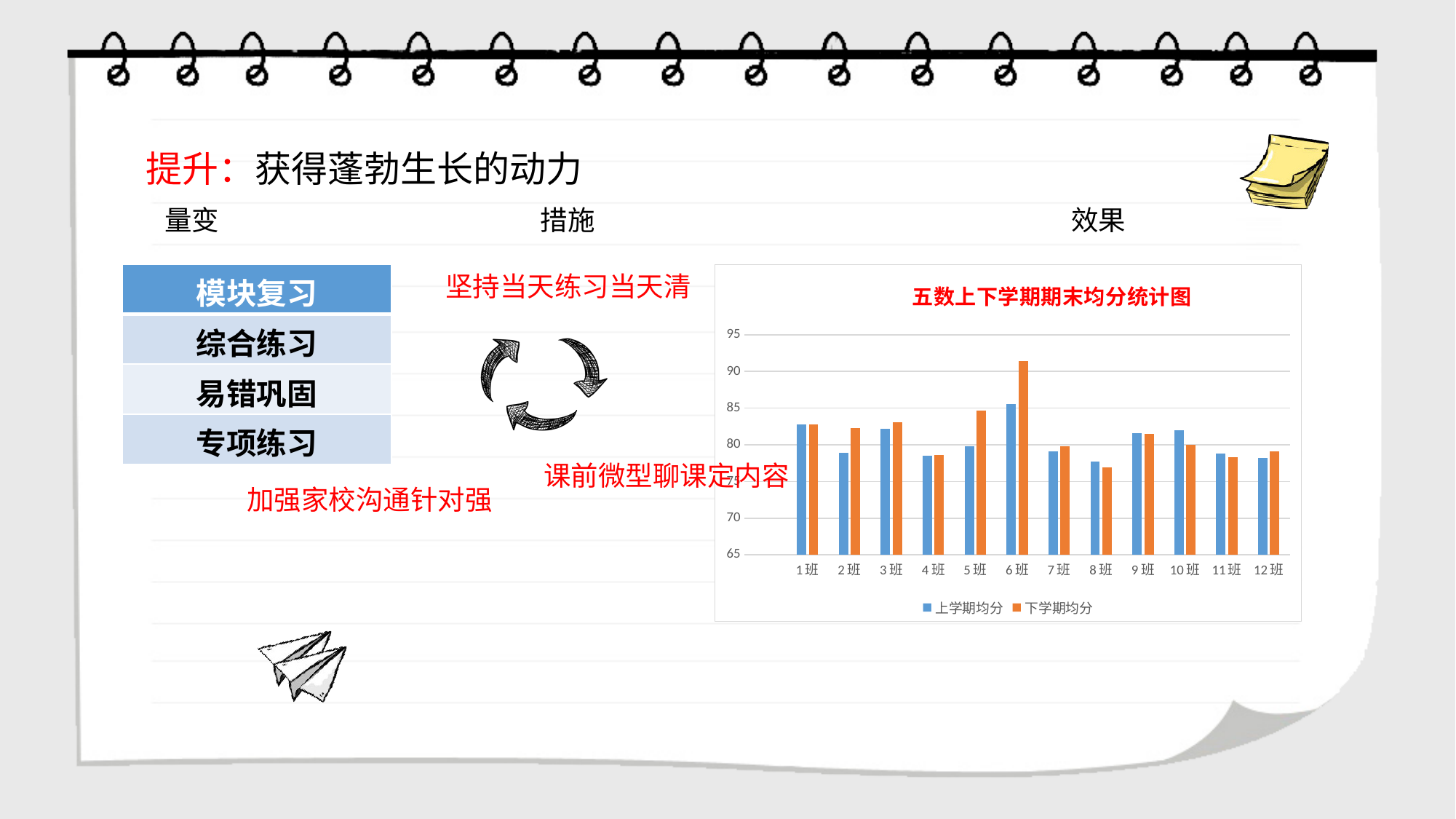
Is the 下学期均分 for 8班 greater or less than 80? less How many series does the chart's legend list? 2 Is the 下学期均分 for 6班 greater or less than 90? greater What is the title of the chart on the slide? 五数上下学期期末均分统计图 For 5班, which is larger: 上学期均分 or 下学期均分? 下学期均分 Which class has the highest 上学期均分 in the chart? 6班 For 10班, which is larger: 上学期均分 or 下学期均分? 上学期均分 Is the 上学期均分 for 4班 greater or less than 80? less What kind of chart is shown on the slide? bar chart How many classes (categories) are shown on the x axis of the chart? 12 Which class has the lowest 下学期均分 in the chart? 8班 Which class has the highest 下学期均分 in the chart? 6班